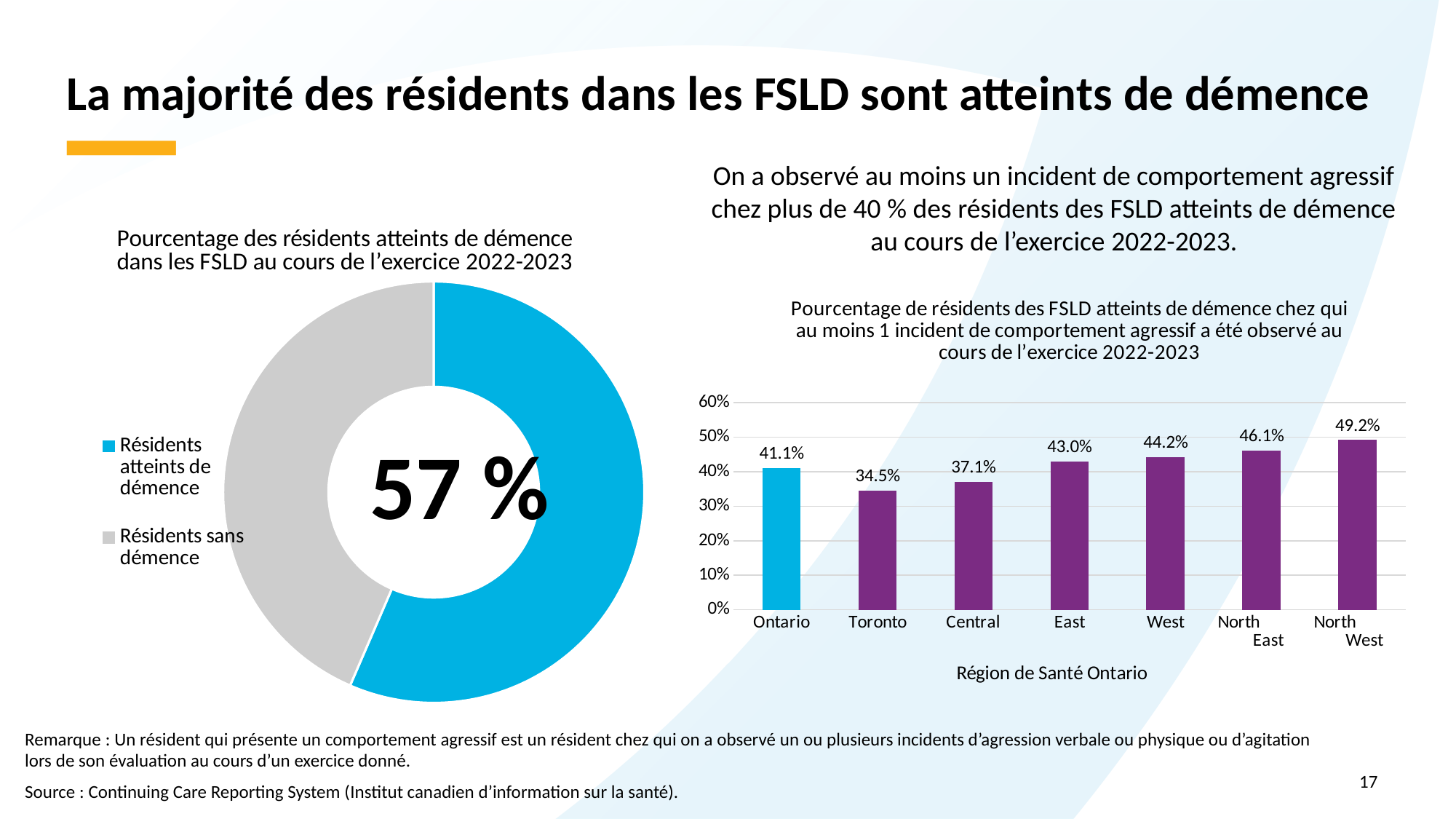
What share of the donut chart on the left is taken by residents with dementia (Résidents atteints de démence)? 57 % In the bar chart on the right, do the values rise or fall from Toronto to North West? rise In the bar chart on the right, which is larger, the value for East or the value for Central? East In the bar chart on the right, which region has the highest value? North West How many regions are shown in the bar chart on the right? 7 In the bar chart on the right, what is the value for Toronto? 34.5% In the bar chart on the right, what is the value for Ontario? 41.1% In the bar chart on the right, is the value for West greater or less than 40%? greater How many entries does the legend of the donut chart on the left list? 2 In the bar chart on the right, what is the value for North West? 49.2% In the bar chart on the right, which region has the lowest value? Toronto In the bar chart on the right, what is the difference between the values for North West and Toronto? 14.7%